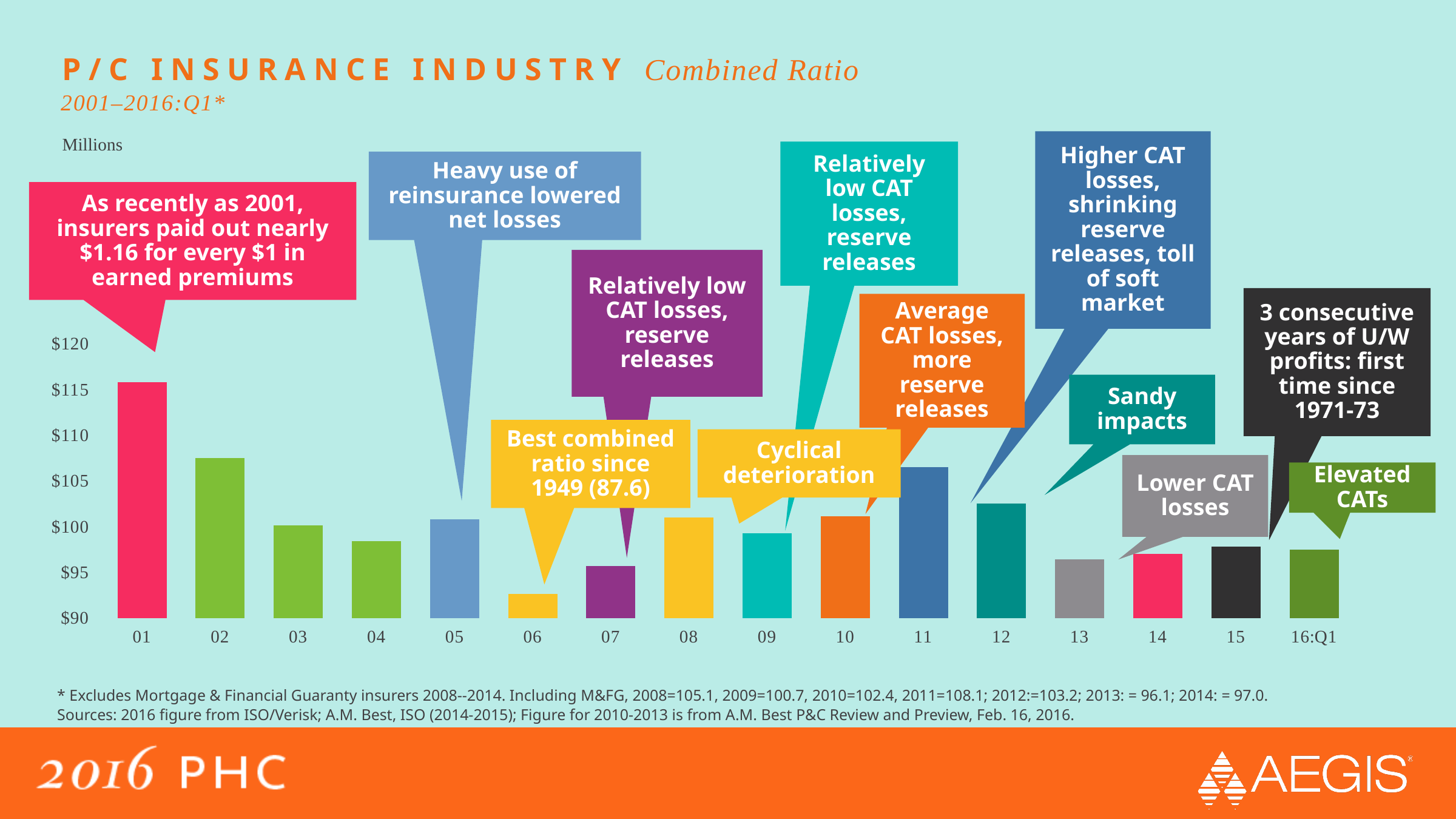
Is the value for 06 greater or less than $95? less What is the title of the chart? P/C Insurance Industry Combined Ratio 2001–2016:Q1* Is the value for 01 greater or less than $110? greater What kind of chart is shown on the slide? Bar chart How many bars (years/periods) are plotted on the chart? 16 Which year has the lowest combined ratio bar? 06 Which is larger, the bar for 11 or the bar for 12? 11 Do the bars rise or fall from 01 to 06? Fall Which year has the highest combined ratio bar? 01 Which is larger, the bar for 06 or the bar for 07? 07 Is the value for 02 greater or less than $105? greater